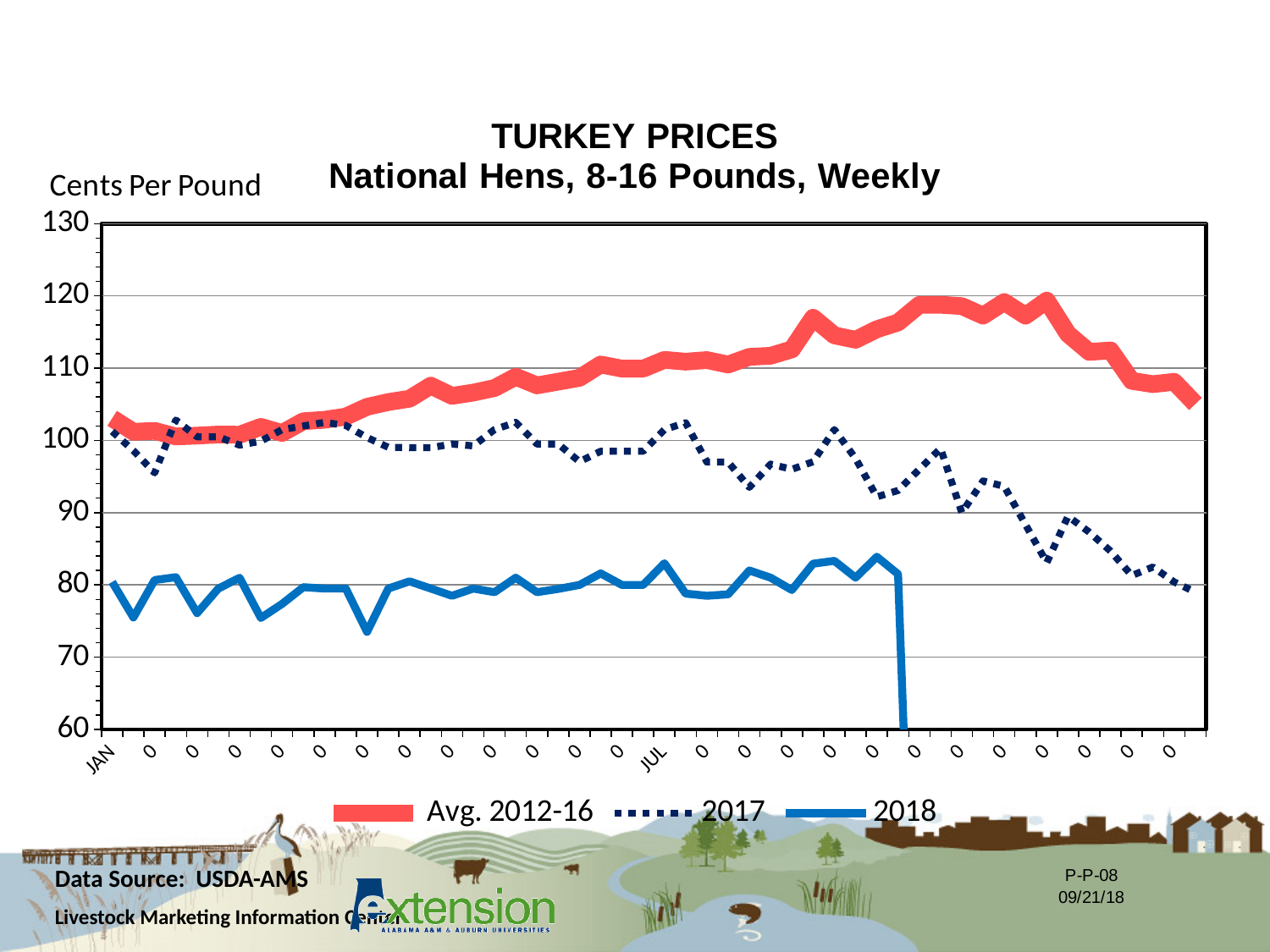
Which series has the highest values across the year? Avg. 2012-16 Is the value of the 2018 line in January greater or less than 90? less In January, which is higher, the Avg. 2012-16 line or the 2018 line? Avg. 2012-16 Is the peak value of the Avg. 2012-16 line greater or less than 110? greater What unit is shown on the vertical axis label? Cents Per Pound How many series does the legend list? 3 What kind of chart is shown on the slide? line chart Does the Avg. 2012-16 line rise or fall from January to July? rise Does the 2017 line rise or fall from July to the end of the year? fall What is the title of the chart? TURKEY PRICES, National Hens, 8-16 Pounds, Weekly Around July, which is higher, the 2017 line or the 2018 line? 2017 Which series has the lowest values across the year? 2018